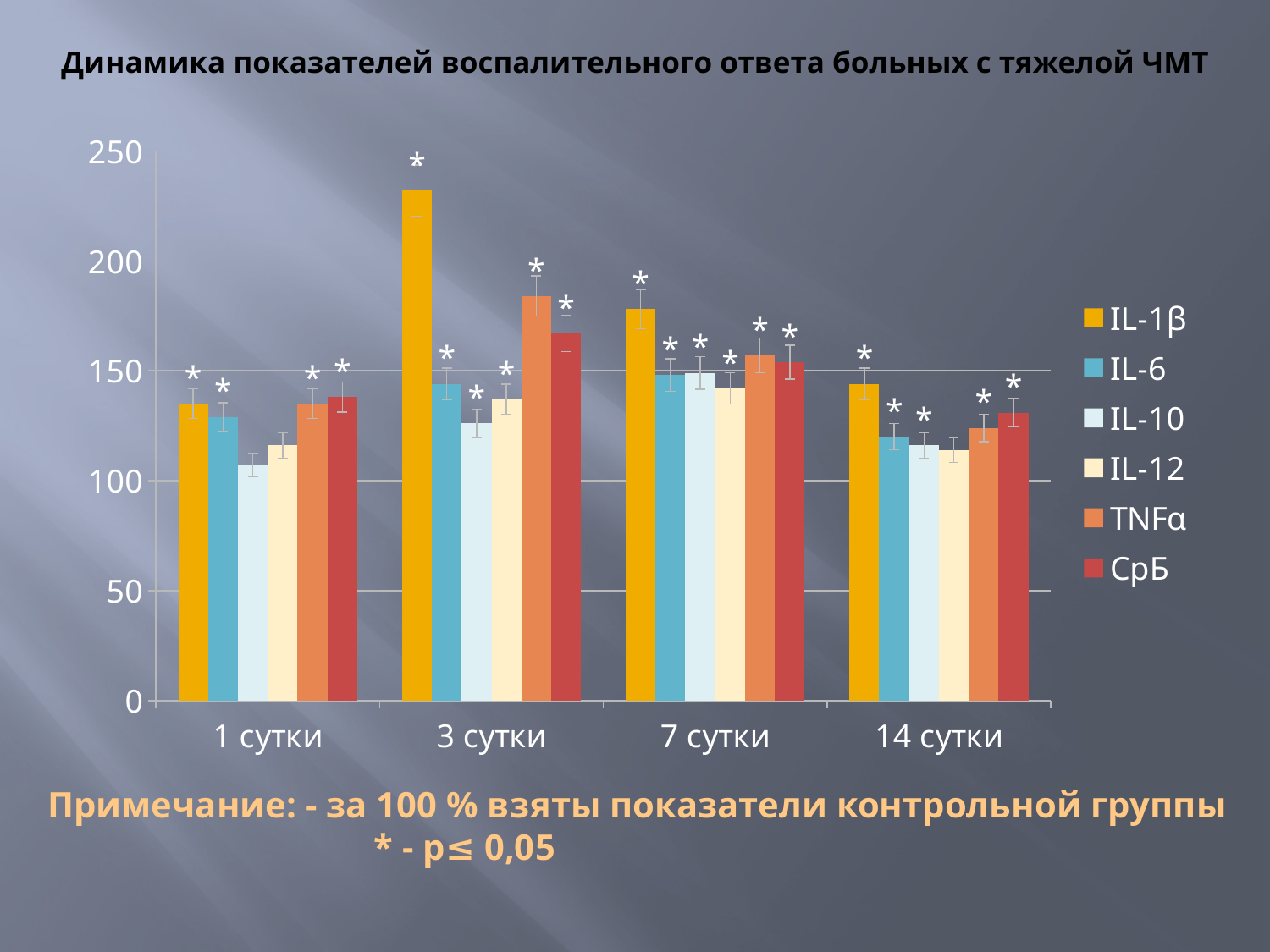
How many time-point categories are shown on the x axis? 4 According to the note below the chart, what is taken as 100%? показатели контрольной группы Is the value for TNFα at 3 сутки greater or less than 150? greater How many series does the legend list? 6 Does the IL-1β value rise or fall from 3 сутки to 14 сутки? falls What kind of chart is shown on the slide? bar chart Is the value for IL-10 at 1 сутки greater or less than 150? less At 3 сутки, which is larger: TNFα or IL-6? TNFα At 7 сутки, which series has the highest value? IL-1β At which time point is the IL-1β value highest? 3 сутки Is the value for IL-1β at 3 сутки greater or less than 200? greater At 3 сутки, which series has the lowest value? IL-10